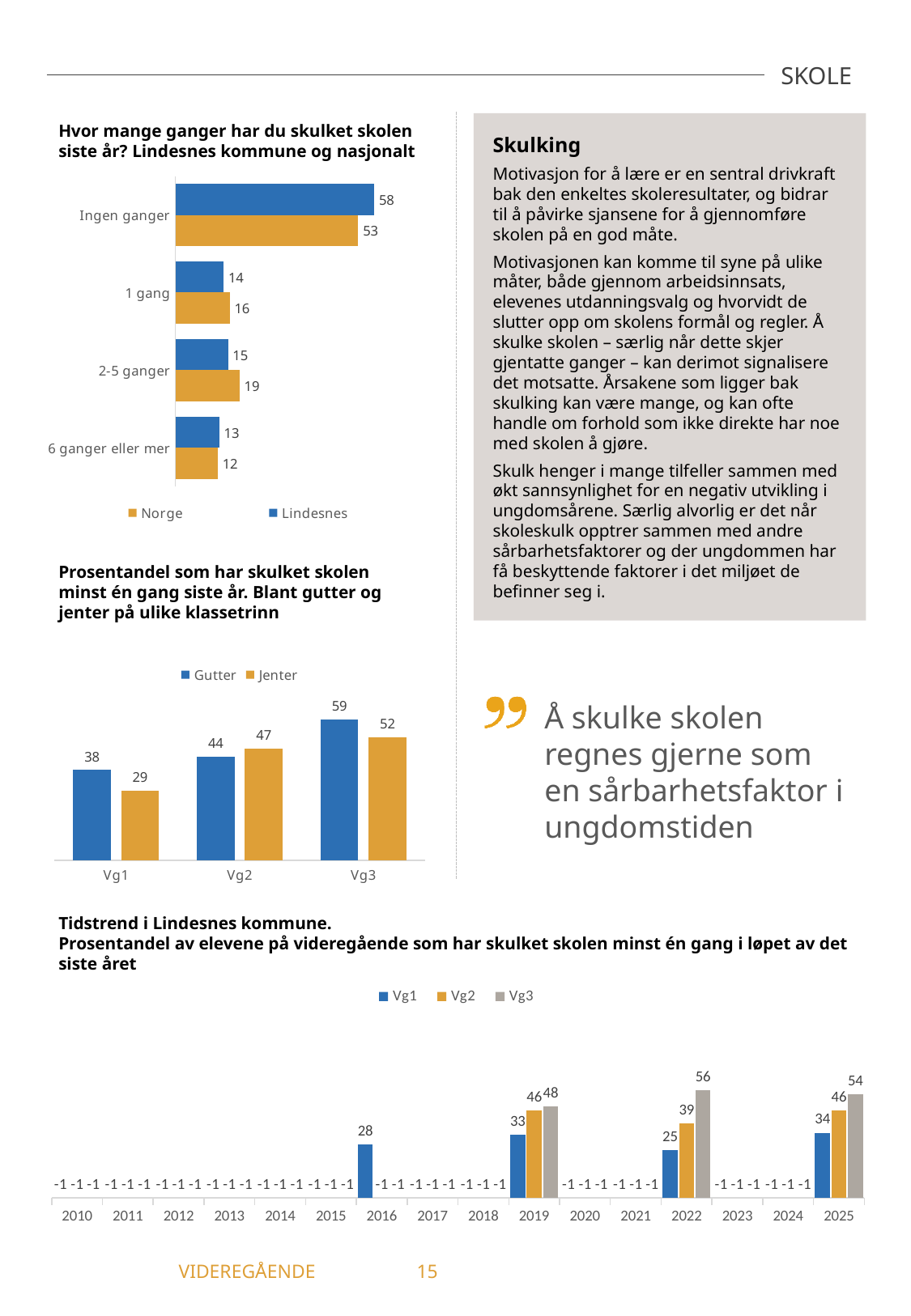
What type of chart is 'Hvor mange ganger har du skulket skolen siste år?'? Bar chart In the chart 'Hvor mange ganger har du skulket skolen siste år?', what is the difference between Norge and Lindesnes for '1 gang'? 2 In the chart 'Hvor mange ganger har du skulket skolen siste år?', how many categories are shown? 4 In the chart 'Tidstrend i Lindesnes kommune', what is the difference between Vg3 and Vg1 in 2025? 20 In the chart 'Prosentandel som har skulket skolen minst én gang siste år', which class level has the highest value for Gutter? Vg3 In the chart 'Hvor mange ganger har du skulket skolen siste år?', what is the value for Norge in the category '2-5 ganger'? 19 In the chart 'Tidstrend i Lindesnes kommune', what is the value for Vg3 in 2022? 56 In the chart 'Hvor mange ganger har du skulket skolen siste år?', what is the value for Lindesnes in the category 'Ingen ganger'? 58 In the chart 'Prosentandel som har skulket skolen minst én gang siste år', what is the value for Jenter at Vg1? 29 In the chart 'Prosentandel som har skulket skolen minst én gang siste år', which is larger at Vg2: Gutter or Jenter? Jenter In the chart 'Prosentandel som har skulket skolen minst én gang siste år', how many series does the legend list? 2 In the chart 'Tidstrend i Lindesnes kommune', what is the value for Vg1 in 2016? 28